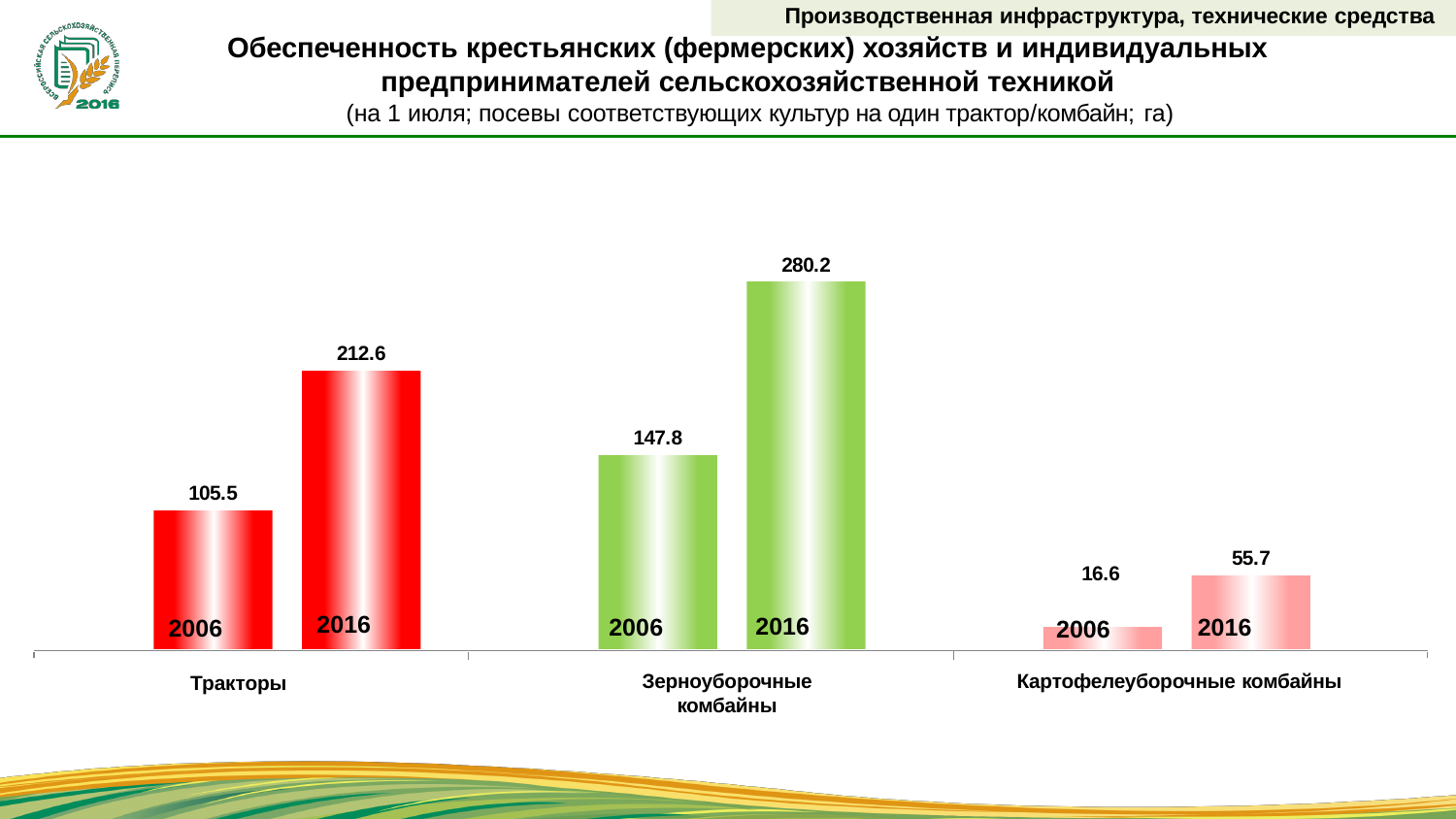
What is the value for Зерноуборочные комбайны in 2006? 147.8 What is the value for Тракторы in 2016? 212.6 What is the value for Картофелеуборочные комбайны in 2016? 55.7 Which category has the highest value in 2016? Зерноуборочные комбайны Which category has the lowest value in 2006? Картофелеуборочные комбайны For each category, does the value rise or fall from 2006 to 2016? Rise What kind of chart is shown on the slide? Bar chart Which is larger: the 2016 value for Тракторы or the 2006 value for Зерноуборочные комбайны? 2016 value for Тракторы What is the difference between the 2016 and 2006 values for Зерноуборочные комбайны? 132.4 What is the difference between the 2016 and 2006 values for Тракторы? 107.1 How many categories are shown on the x axis? 3 What is the value for Тракторы in 2006? 105.5